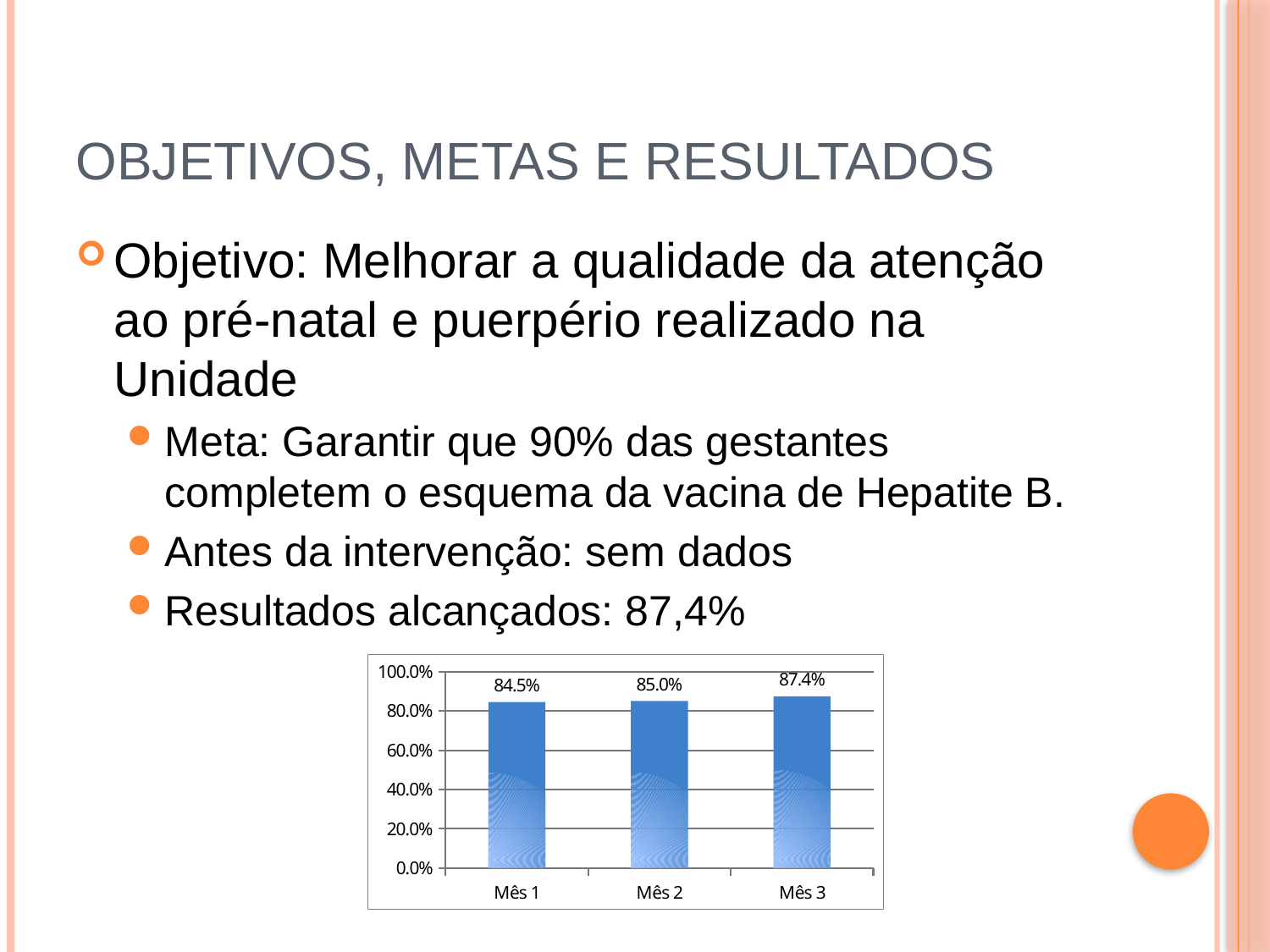
What is the value for Mês 2? 85.0% How many categories are shown on the x axis? 3 Which month has the highest value? Mês 3 Which month has the lowest value? Mês 1 What kind of chart is shown on the slide? bar chart Do the values rise or fall from Mês 1 to Mês 3? rise What is the value for Mês 1? 84.5% What is the value for Mês 3? 87.4% Is the value for Mês 3 greater or less than 80.0%? greater What is the difference between the values for Mês 2 and Mês 1? 0.5% What is the difference between the values for Mês 3 and Mês 1? 2.9% Which is larger, the value for Mês 3 or the value for Mês 2? Mês 3